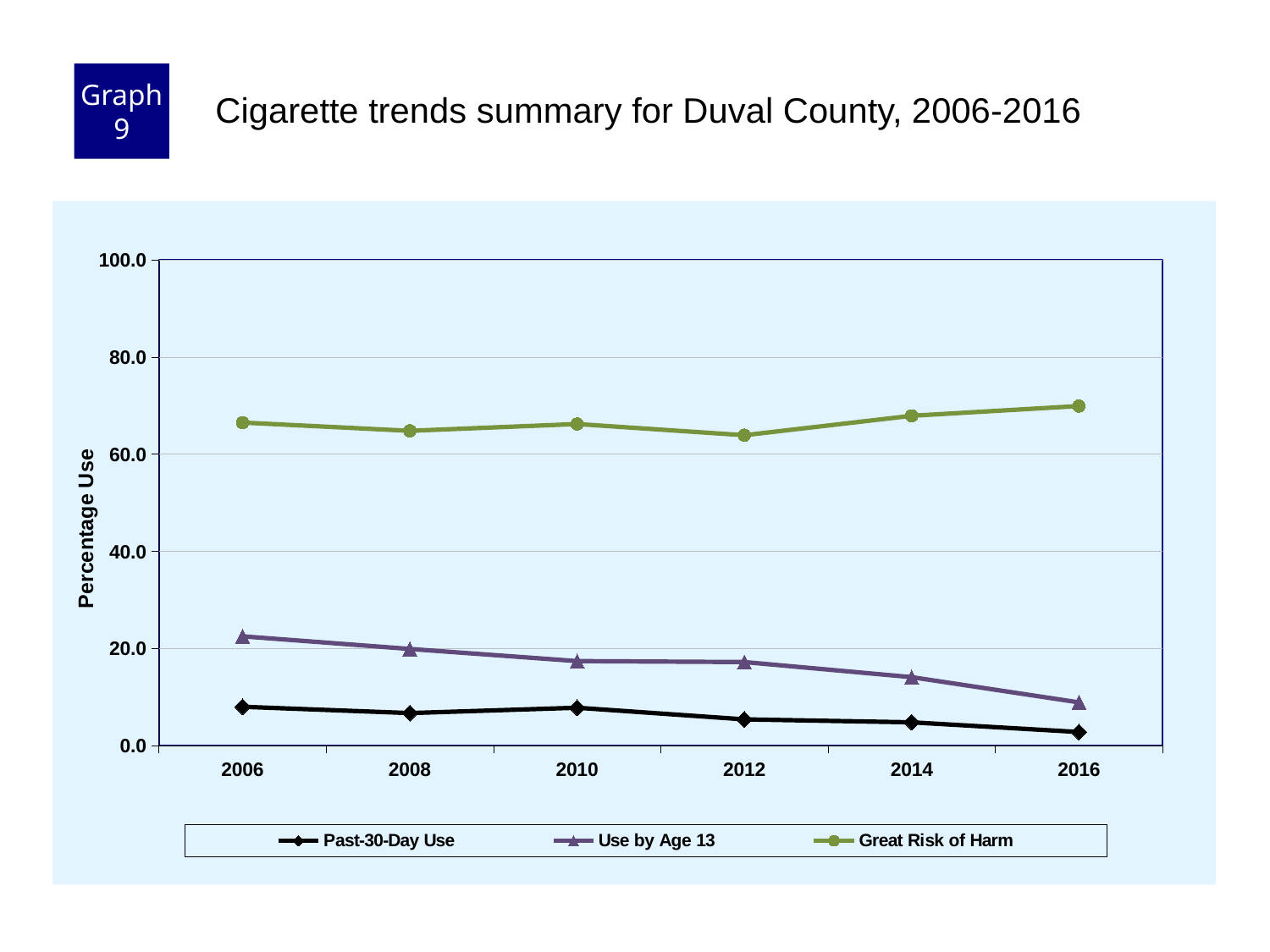
How many series does the legend list? 3 In which year is Past-30-Day Use lowest? 2016 Is the value for Past-30-Day Use in 2006 greater or less than 20? less How many years are plotted along the x axis? 6 In which year is Use by Age 13 highest? 2006 In which year is Great Risk of Harm highest? 2016 Is the value for Use by Age 13 in 2016 greater or less than 20? less Is the value for Great Risk of Harm in 2016 greater or less than 60? greater Does the Use by Age 13 series rise or fall from 2006 to 2016? Fall In 2010, which is larger: Great Risk of Harm or Use by Age 13? Great Risk of Harm What kind of chart is shown on the slide? Line chart What is the label on the y axis? Percentage Use